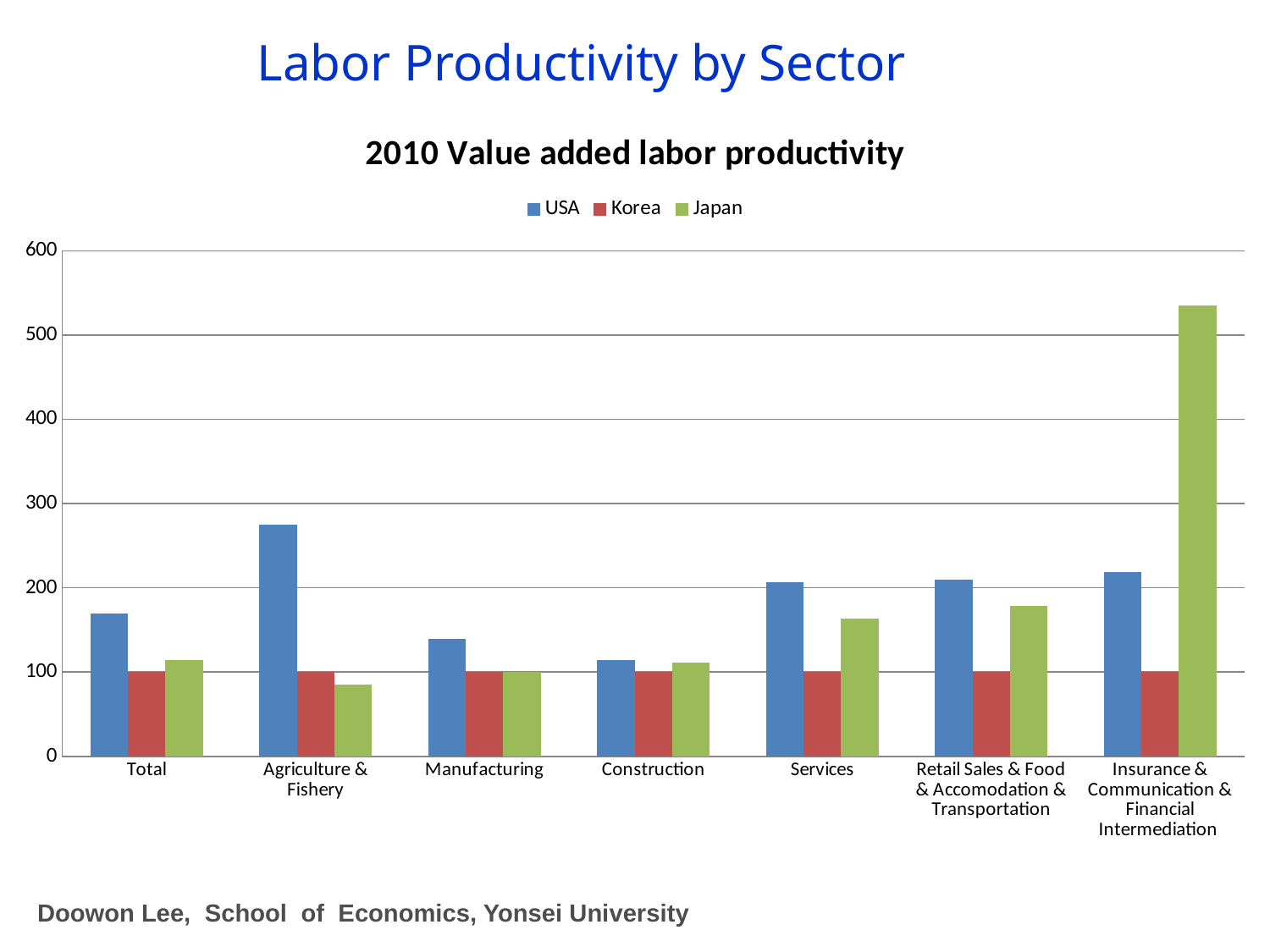
In which category is the USA value lowest? Construction What is the title of the chart? 2010 Value added labor productivity What is the value for Korea in the Services category? 100 Is the value for Japan in Insurance & Communication & Financial Intermediation greater or less than 500? greater How many series does the legend list? 3 In which category is the USA value highest? Agriculture & Fishery Is the value for USA in Total greater or less than 200? less In which category is the Japan value highest? Insurance & Communication & Financial Intermediation Which is larger in Agriculture & Fishery, the USA value or the Japan value? USA What kind of chart is shown on the slide? bar chart How many sector categories are shown on the x axis? 7 In which category is the Japan value lowest? Agriculture & Fishery